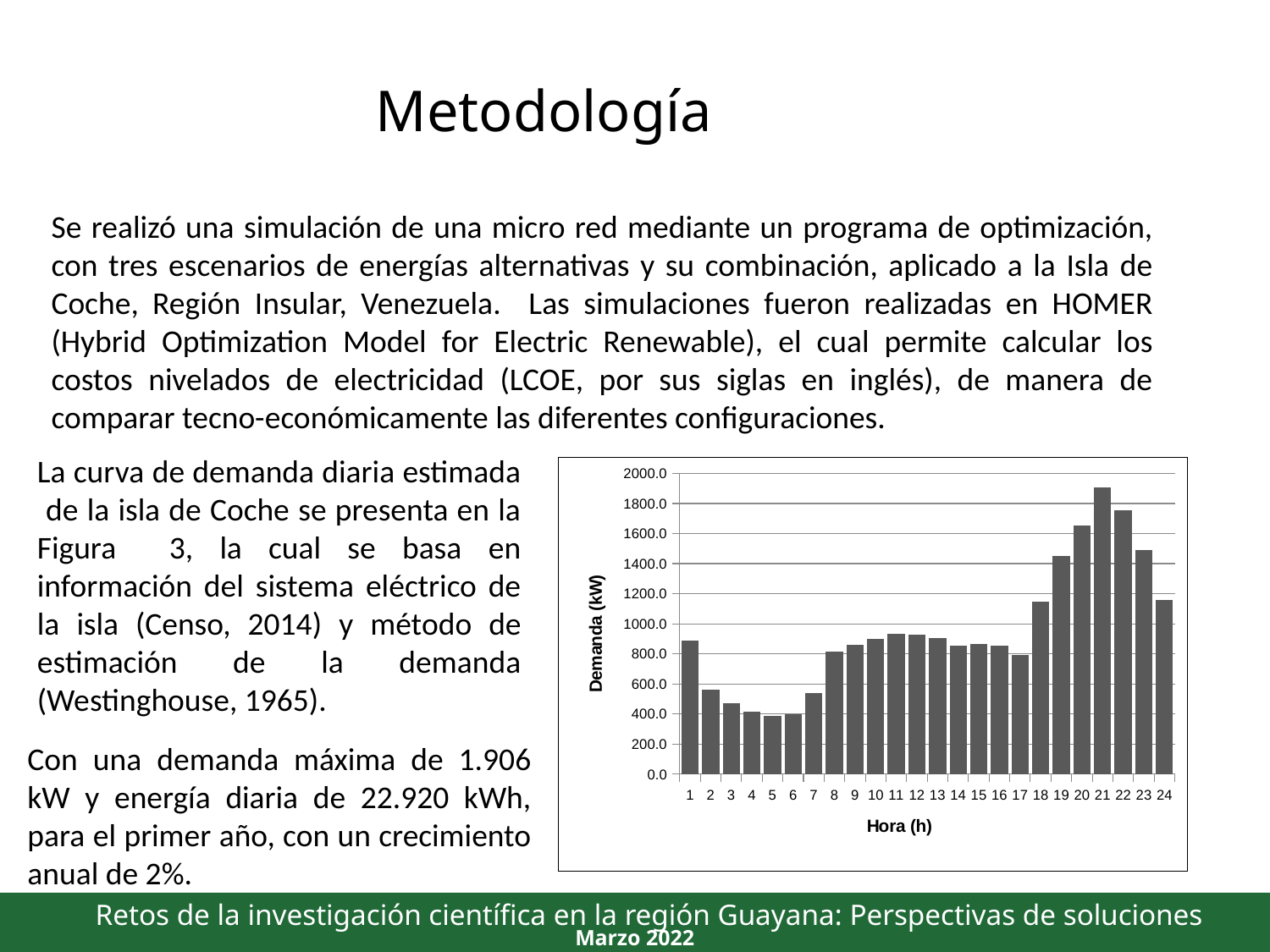
Which hour has the larger demand, hour 20 or hour 23? 20 Is the demand value for hour 4 greater or less than 600.0? less How many hours (bars) are plotted on the x axis of the chart? 24 At which hour is the demand highest in the chart? 21 Is the demand value for hour 21 greater or less than 1800.0? greater What is the label of the y axis of the chart? Demanda (kW) Does the demand rise or fall from hour 17 to hour 21? rise What kind of chart is shown on the slide? bar chart Is the demand value for hour 24 greater or less than 1000.0? greater Which hour has the larger demand, hour 21 or hour 22? 21 What is the label of the x axis of the chart? Hora (h)